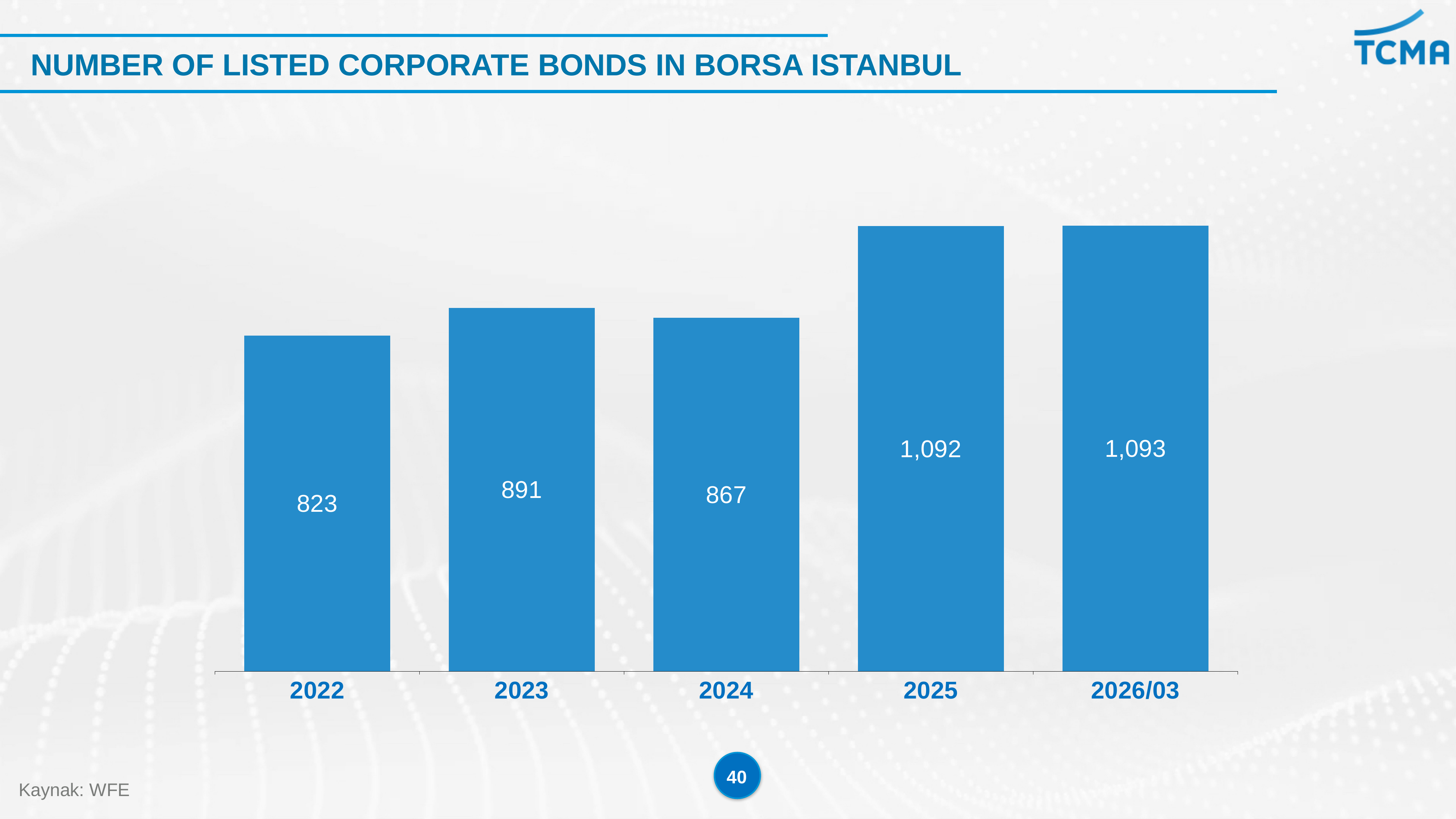
What is the value shown for 2024? 867 Did the number of listed corporate bonds rise or fall from 2023 to 2024? Fall Which year has the lowest number of listed corporate bonds? 2022 What is the difference between the values for 2025 and 2024? 225 How many bars are shown in the chart? 5 What source is cited for the chart? WFE What is the title of the chart? NUMBER OF LISTED CORPORATE BONDS IN BORSA ISTANBUL Which is larger, the value for 2023 or the value for 2024? 2023 What kind of chart is shown on the slide? Bar chart What is the value shown for 2026/03? 1,093 What is the number of listed corporate bonds in Borsa Istanbul in 2022? 823 What is the difference between the values for 2023 and 2022? 68